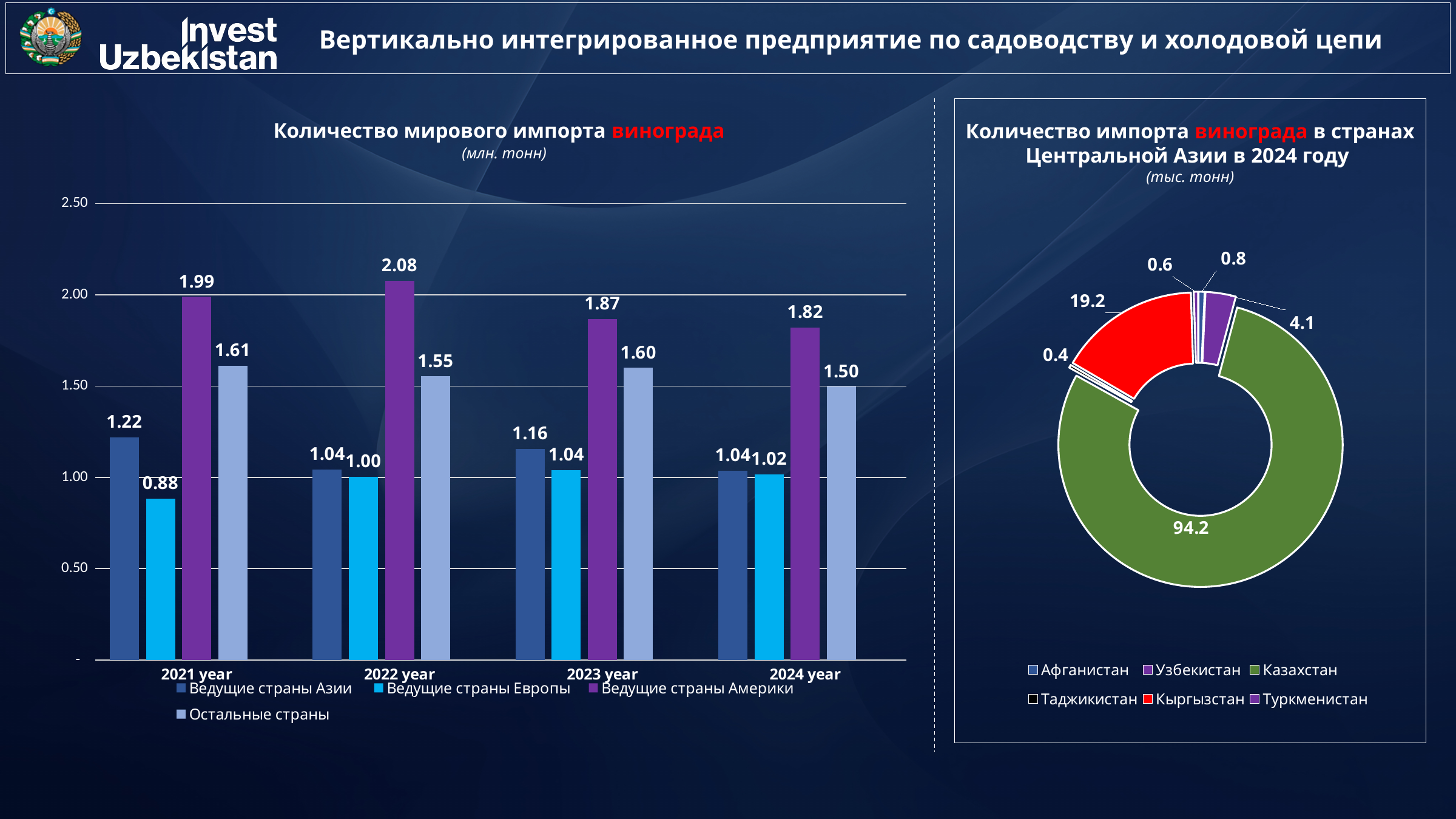
In the left chart 'Количество мирового импорта винограда', which is larger in 2023 year: Ведущие страны Азии or Ведущие страны Европы? Ведущие страны Азии What kind of chart is the left chart 'Количество мирового импорта винограда'? bar chart In the left chart 'Количество мирового импорта винограда', how many series does the legend list? 4 In the left chart 'Количество мирового импорта винограда', what is the value for Ведущие страны Америки in 2022 year? 2.08 In the left chart 'Количество мирового импорта винограда', in which year is the value for Ведущие страны Европы the lowest? 2021 year In the left chart 'Количество мирового импорта винограда', in which year is the value for Ведущие страны Америки the highest? 2022 year In the left chart 'Количество мирового импорта винограда', what is the difference between Ведущие страны Америки and Ведущие страны Азии in 2021 year? 0.77 In the right chart 'Количество импорта винограда в странах Центральной Азии в 2024 году', what is the difference between Казахстан and Кыргызстан? 75.0 In the left chart 'Количество мирового импорта винограда', what is the value for Ведущие страны Европы in 2021 year? 0.88 In the right chart 'Количество импорта винограда в странах Центральной Азии в 2024 году', what is the value for Казахстан? 94.2 In the left chart 'Количество мирового импорта винограда', do the values for Остальные страны rise or fall from 2021 year to 2024 year? fall In the right chart 'Количество импорта винограда в странах Центральной Азии в 2024 году', which country has the largest slice? Казахстан